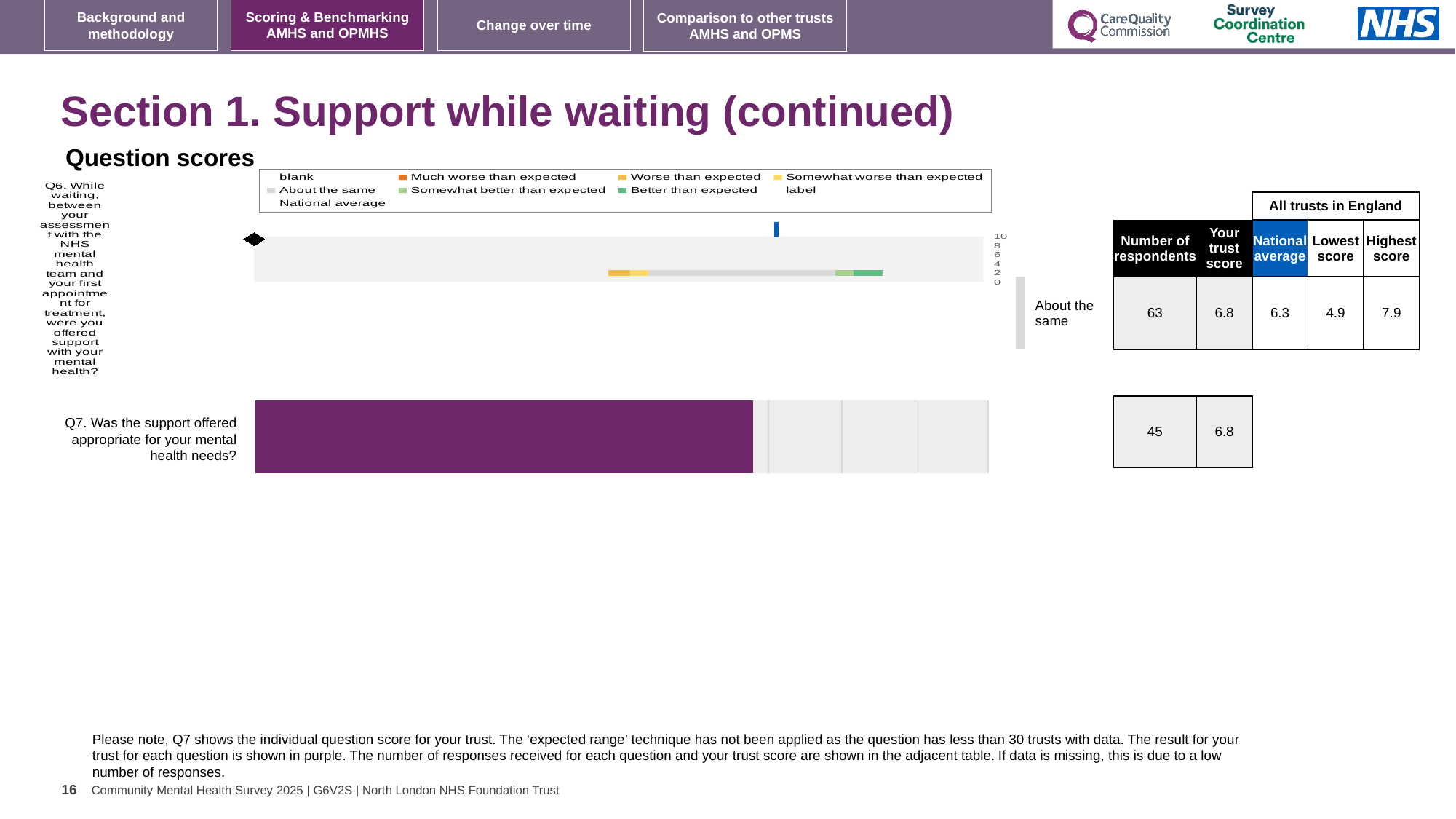
How many respondents answered Q7 (was the support offered appropriate)? 45 What is the lowest score among all trusts in England for Q6? 4.9 What is the national average score for Q6? 6.3 Is the trust score for Q6 higher or lower than the national average? higher How many respondents answered Q6? 63 What is the trust score for Q6 (support offered while waiting)? 6.8 What category label is shown for the Q6 result compared with the expected range? About the same What is the difference between the highest and lowest scores among all trusts in England for Q6? 3.0 Is the value of the purple bar for Q7 greater or less than 6? greater What is the trust score for Q7? 6.8 What is the highest score among all trusts in England for Q6? 7.9 What is the difference between the trust score and the national average for Q6? 0.5